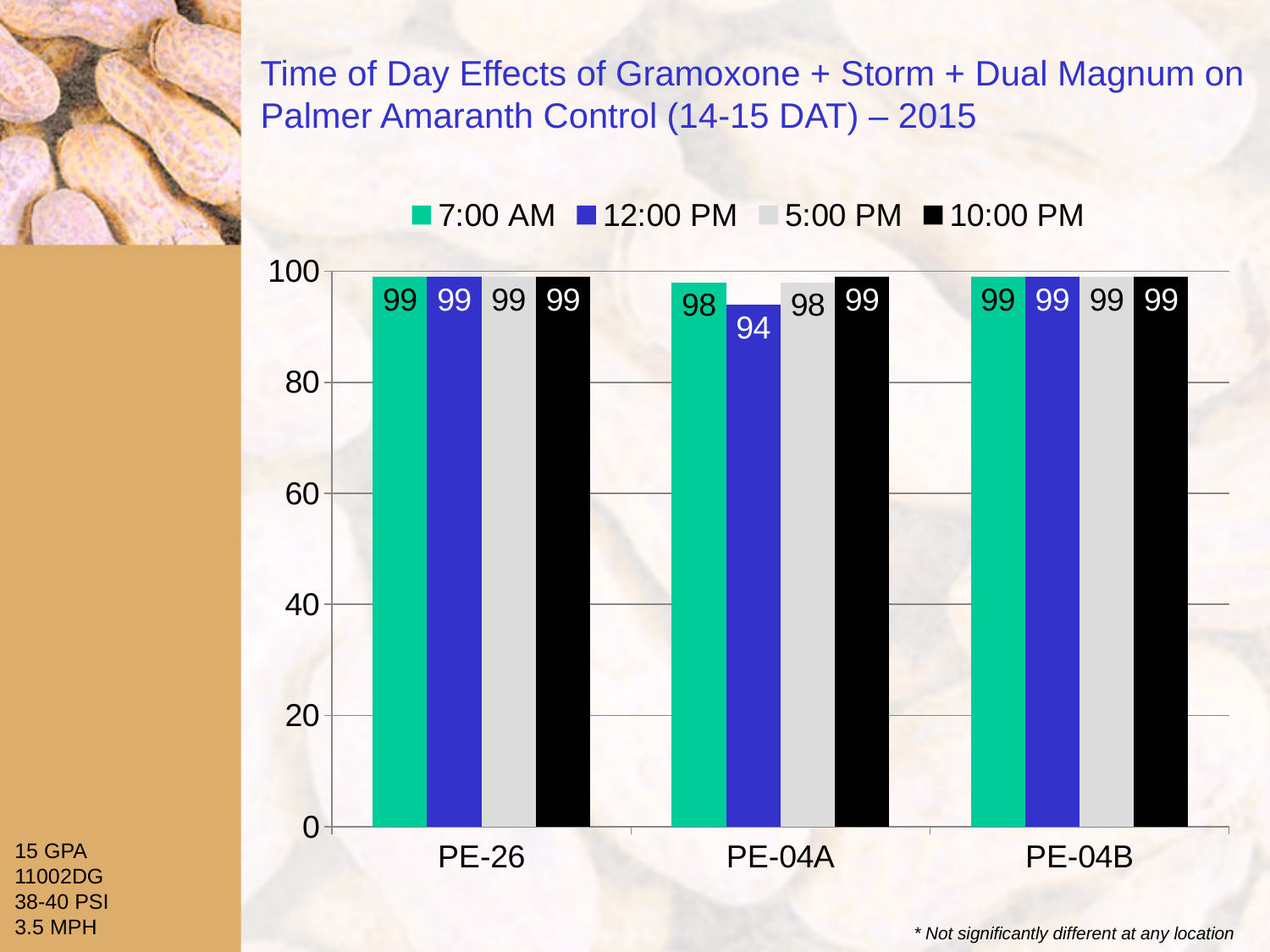
How many series does the legend list? 4 Which time of day has the lowest value at PE-04A? 12:00 PM How many locations are shown on the x axis? 3 Is the value for 12:00 PM at PE-04A greater or less than 80? greater What is the difference between the 7:00 AM and 12:00 PM values at PE-04A? 4 What is the value for 5:00 PM at PE-04B? 99 What is the value for 7:00 AM at PE-04A? 98 What is the value for 10:00 PM at PE-26? 99 What is the value for 12:00 PM at PE-04A? 94 What is the difference between the 10:00 PM and 12:00 PM values at PE-04A? 5 What kind of chart is shown on the slide? Bar chart Which is larger at PE-04A: the 5:00 PM value or the 12:00 PM value? 5:00 PM